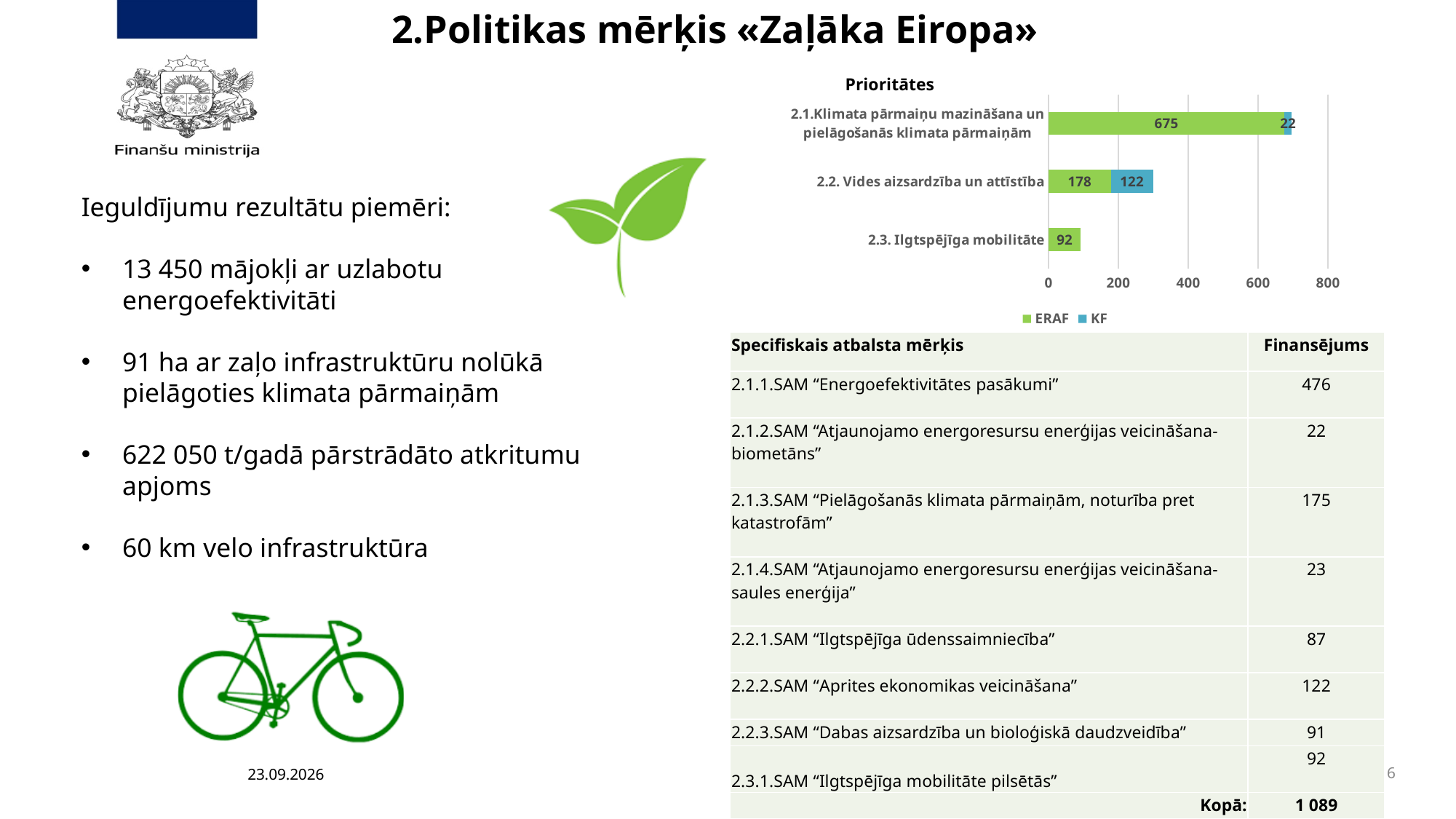
Which category has the highest ERAF value in the Prioritātes chart? 2.1.Klimata pārmaiņu mazināšana un pielāgošanās klimata pārmaiņām How many categories are shown in the Prioritātes chart? 3 What is the total of the stacked bar for "2.2. Vides aizsardzība un attīstība" in the Prioritātes chart? 300 What is the difference between the ERAF values for "2.1.Klimata pārmaiņu mazināšana un pielāgošanās klimata pārmaiņām" and "2.2. Vides aizsardzība un attīstība" in the Prioritātes chart? 497 What is the KF value for "2.2. Vides aizsardzība un attīstība" in the Prioritātes chart? 122 What kind of chart is the Prioritātes chart? Stacked horizontal bar chart What is the ERAF value for the category "2.1.Klimata pārmaiņu mazināšana un pielāgošanās klimata pārmaiņām" in the Prioritātes chart? 675 What is the KF value for "2.1.Klimata pārmaiņu mazināšana un pielāgošanās klimata pārmaiņām" in the Prioritātes chart? 22 Which category has the lowest ERAF value in the Prioritātes chart? 2.3. Ilgtspējīga mobilitāte In the Prioritātes chart, which is larger: the ERAF value for "2.2. Vides aizsardzība un attīstība" or the KF value for the same category? ERAF What is the ERAF value for "2.3. Ilgtspējīga mobilitāte" in the Prioritātes chart? 92 How many series does the legend of the Prioritātes chart list? 2